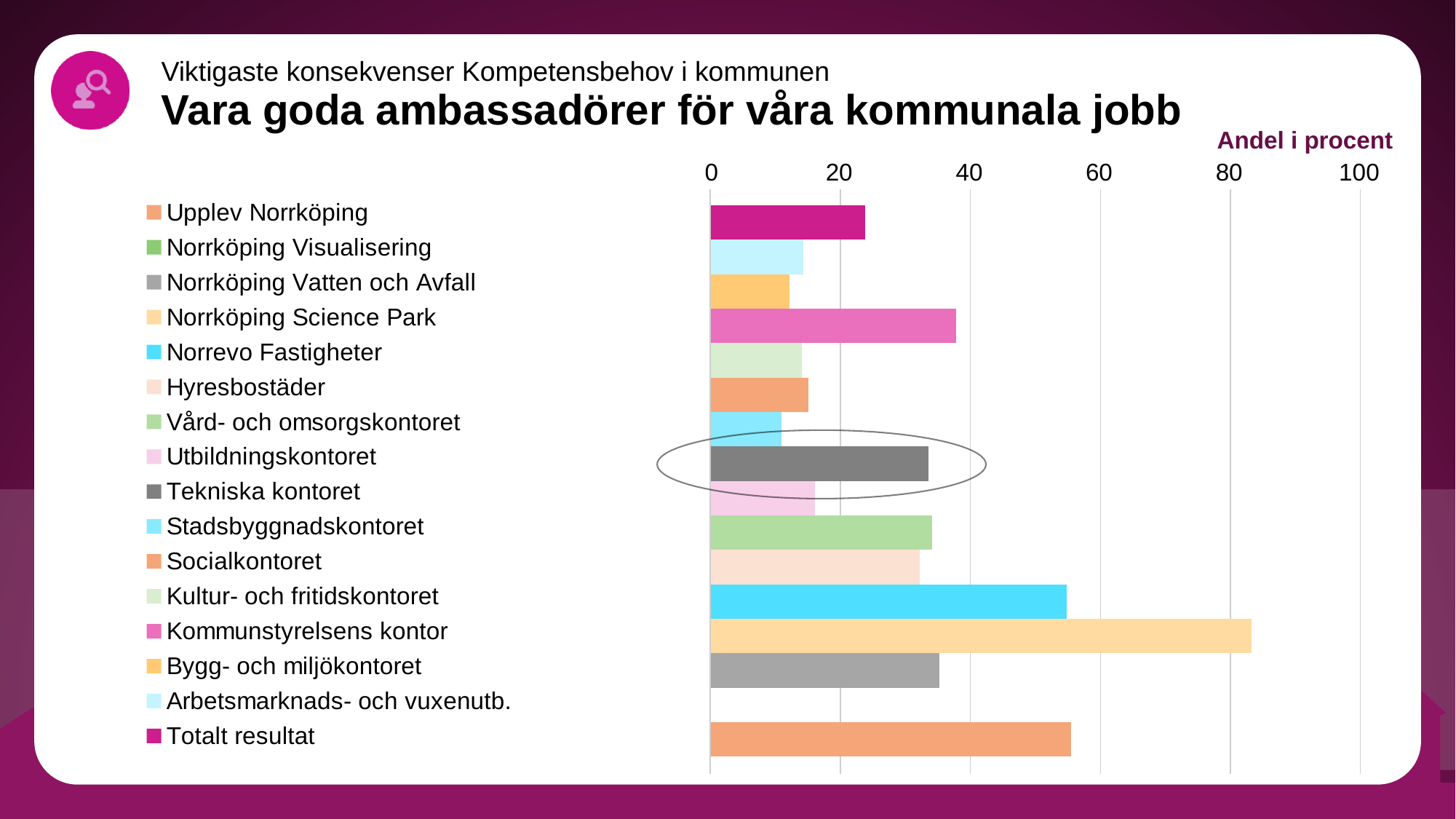
Which category's bar is circled on the chart? Tekniska kontoret Which category has the highest value? Norrköping Science Park How many entries does the legend list? 16 What kind of chart is shown on the slide? bar chart Which is larger, the value for Kommunstyrelsens kontor or the value for Totalt resultat? Kommunstyrelsens kontor Is the value for Norrevo Fastigheter greater or less than 60? less What is the label shown above the horizontal axis of the chart? Andel i procent Is the value for Stadsbyggnadskontoret greater or less than 20? less Is the value for Kommunstyrelsens kontor greater or less than 40? less Which is larger, the value for Norrköping Science Park or the value for Norrevo Fastigheter? Norrköping Science Park